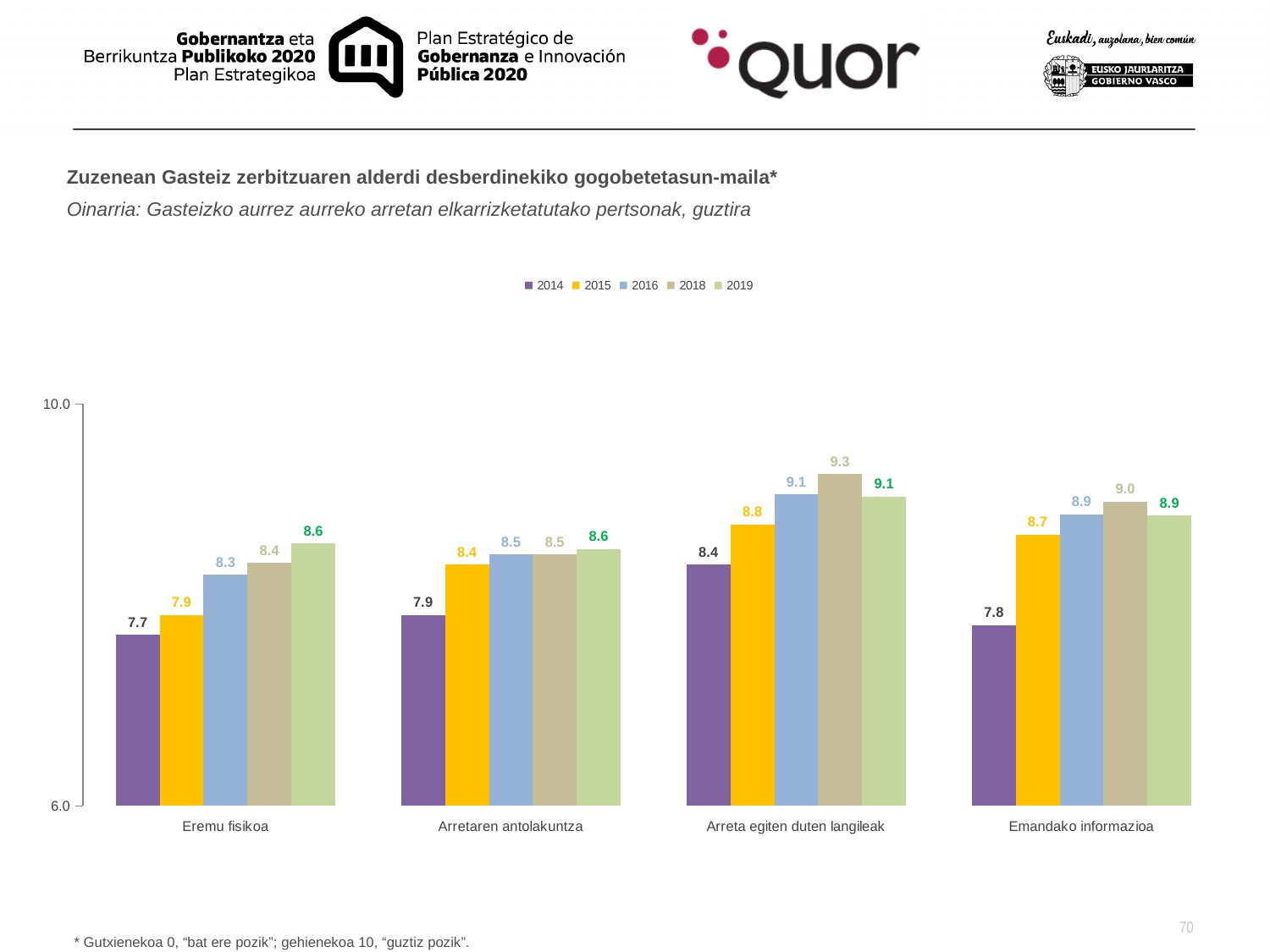
What is the value for 2018 in the Emandako informazioa category? 9.0 Do the values in the Eremu fisikoa category rise or fall from 2014 to 2019? Rise What is the value for 2014 in the Arreta egiten duten langileak category? 8.4 Which category has the highest value for 2018? Arreta egiten duten langileak Which is larger in the Arreta egiten duten langileak category, the 2016 value or the 2018 value? 2018 Which category has the lowest value for 2014? Eremu fisikoa How many series does the legend list? 5 What is the value for 2019 in the Eremu fisikoa category? 8.6 What is the value for 2015 in the Arretaren antolakuntza category? 8.4 How many categories are shown on the x axis? 4 What kind of chart is shown on the slide? Bar chart What is the difference between the 2019 and 2014 values in the Emandako informazioa category? 1.1